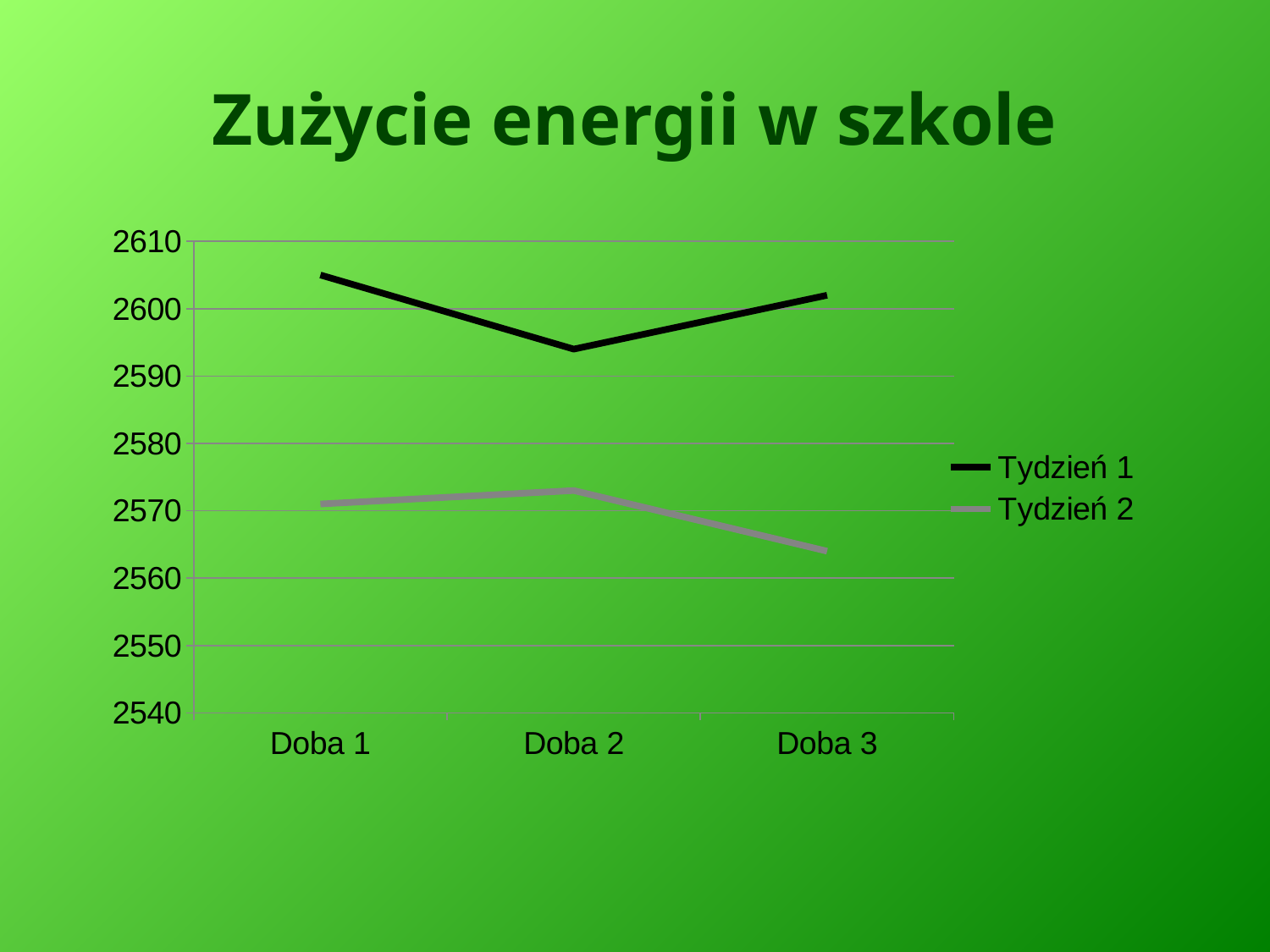
Which series is drawn with the black line? Tydzień 1 What kind of chart is shown on the slide? line chart Is the value for Tydzień 1 at Doba 1 greater or less than 2600? greater Is the value for Tydzień 2 at Doba 3 greater or less than 2570? less Is the value for Tydzień 2 at Doba 2 greater or less than 2580? less What is the title of the chart on the slide? Zużycie energii w szkole How many categories are shown on the x axis? 3 At Doba 1, which series has the larger value, Tydzień 1 or Tydzień 2? Tydzień 1 How many series does the legend list? 2 At which category does Tydzień 1 have its lowest value? Doba 2 At which category does Tydzień 2 have its lowest value? Doba 3